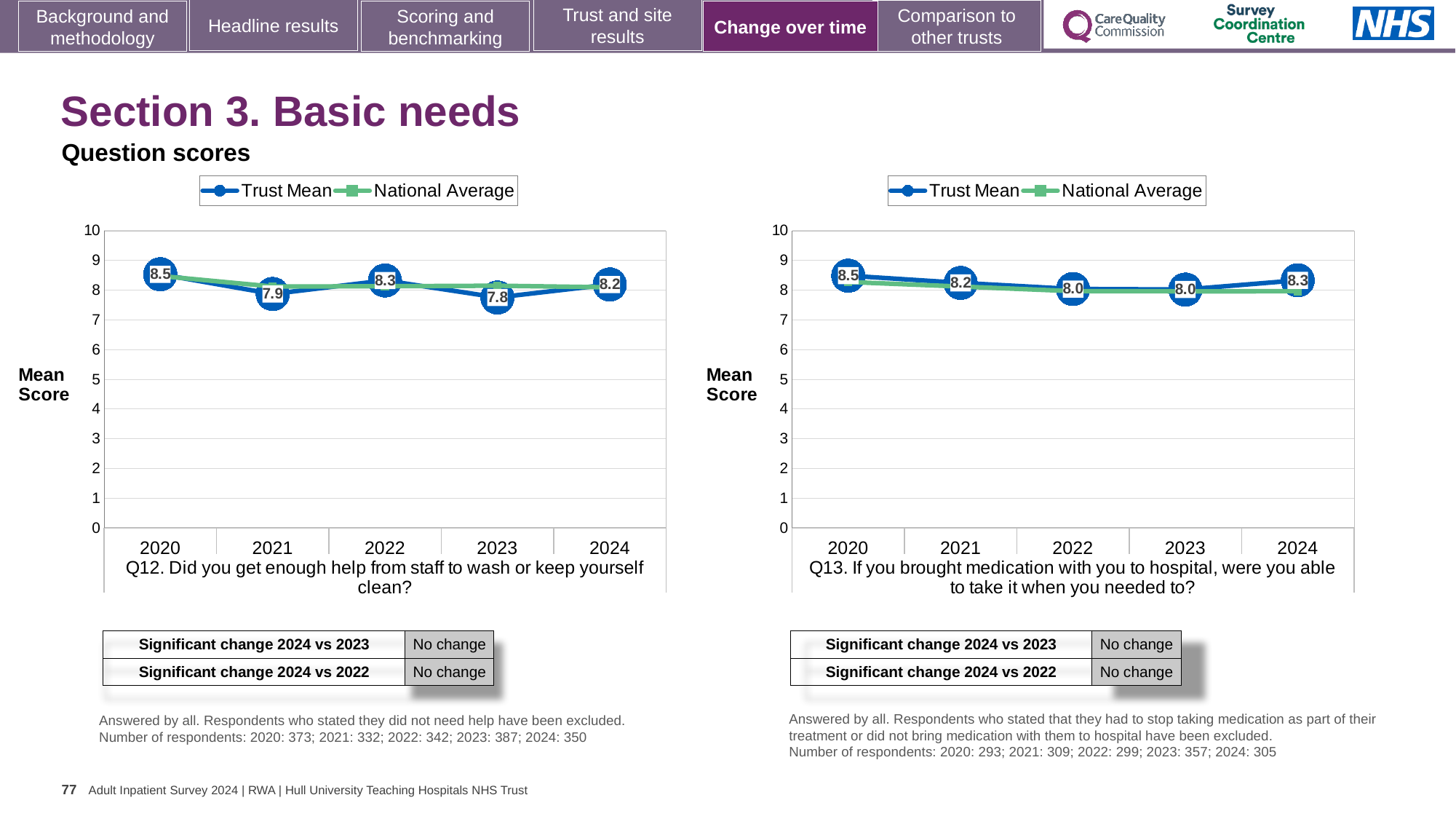
In the Q12 chart (left), is the Trust Mean for 2022 larger than the Trust Mean for 2023? Yes In the Q13 chart (right), what is the Trust Mean for 2024? 8.3 In the Q13 chart (right), which year has the highest Trust Mean? 2020 How many series does the legend of the Q13 chart (right) list? 2 In the Q13 chart (right), what is the difference between the Trust Mean for 2020 and 2022? 0.5 What type of chart is the Q12 chart (left)? Line chart In the Q12 chart (left), what is the difference between the Trust Mean for 2020 and 2021? 0.6 In the Q12 chart (left), what is the Trust Mean for 2023? 7.8 In the Q13 chart (right), is the Trust Mean for 2021 greater or less than 7? greater How many years are plotted on the x axis of the Q12 chart (left)? 5 In the Q12 chart (left), what is the Trust Mean for 2020? 8.5 In the Q12 chart (left), which year has the lowest Trust Mean? 2023